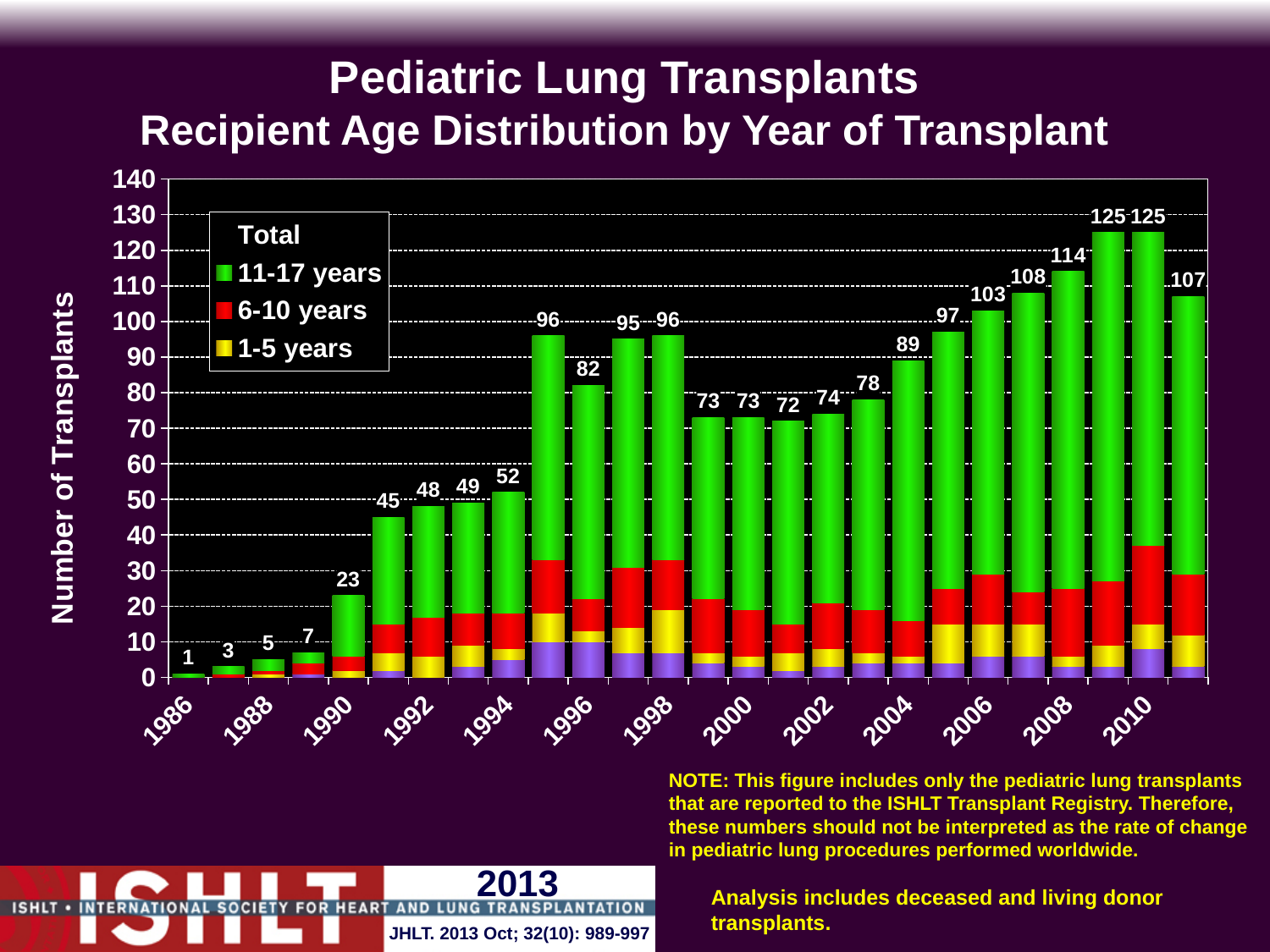
How many years (bars) are shown on the chart? 26 What is the highest total value labeled on the chart? 125 Which year has a larger total, 1997 or 2003? 1997 How many age groups does the legend list? 3 What is the total number of transplants labeled for 1990? 23 What is the total number of pediatric lung transplants shown for 1996? 82 Which year has the lowest total number of transplants? 1986 What is the difference between the total for 2008 and the total for 2006? 11 Is the total for 2004 greater or less than 80? greater What is the total number of transplants labeled for 2011, the last bar on the chart? 107 What is the label of the y-axis? Number of Transplants What type of chart is shown on the slide? Stacked bar chart